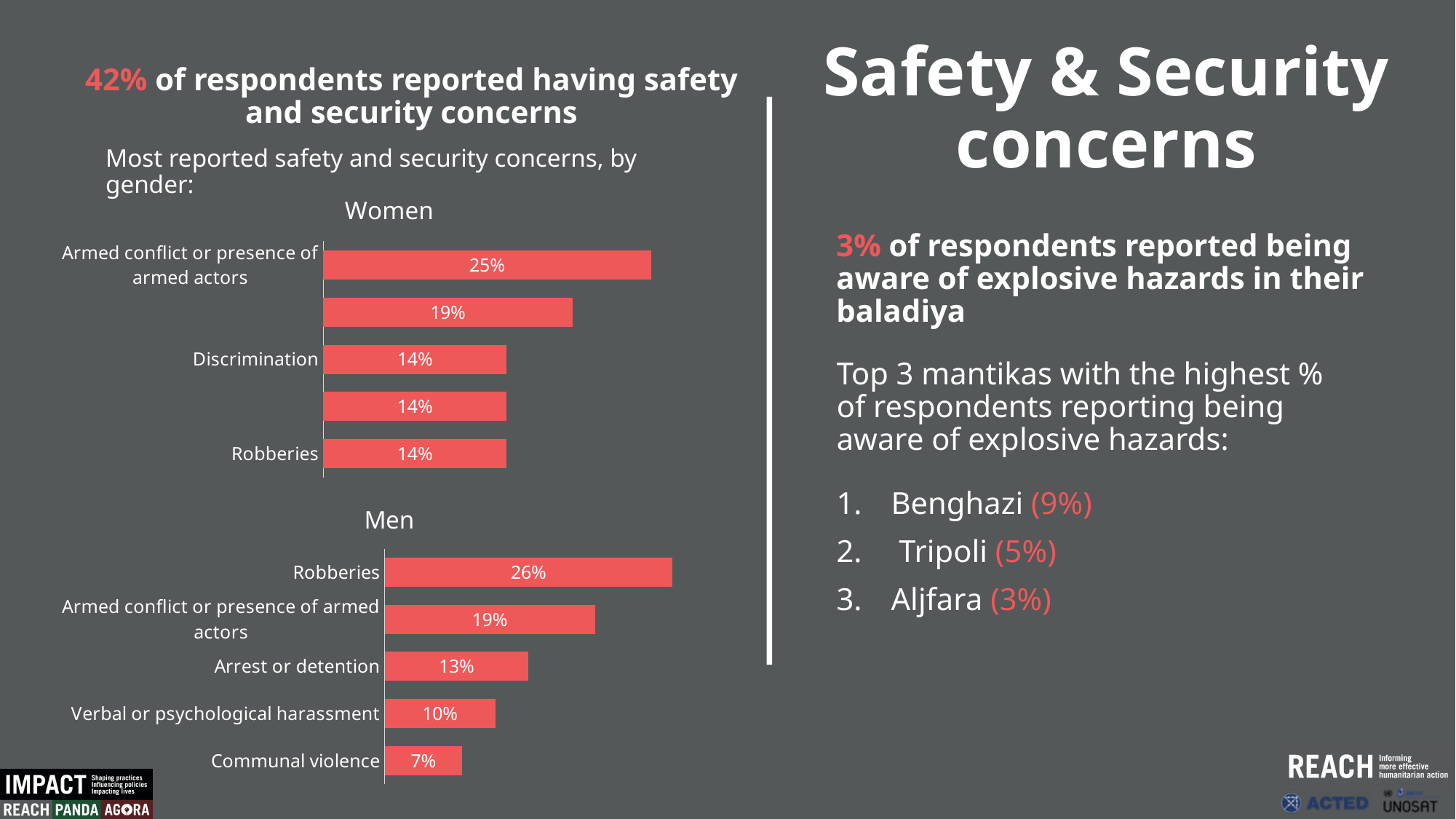
How many bars are shown in the Men chart? 5 In the Men chart, what is the value for Arrest or detention? 13% In the Women chart, what is the value for Discrimination? 14% In the Men chart, which is larger: Armed conflict or presence of armed actors, or Arrest or detention? Armed conflict or presence of armed actors In the Men chart, what percentage of men reported Robberies? 26% In the Men chart, what is the value for Verbal or psychological harassment? 10% What type of chart is the Women chart? Bar chart In the Women chart, which concern has the highest value? Armed conflict or presence of armed actors What is the difference between the Robberies value in the Men chart and the Robberies value in the Women chart? 12% In the Women chart, what percentage of women reported armed conflict or presence of armed actors as a concern? 25% In the Men chart, which concern has the lowest value? Communal violence In the Men chart, what is the difference between Robberies and Communal violence? 19%